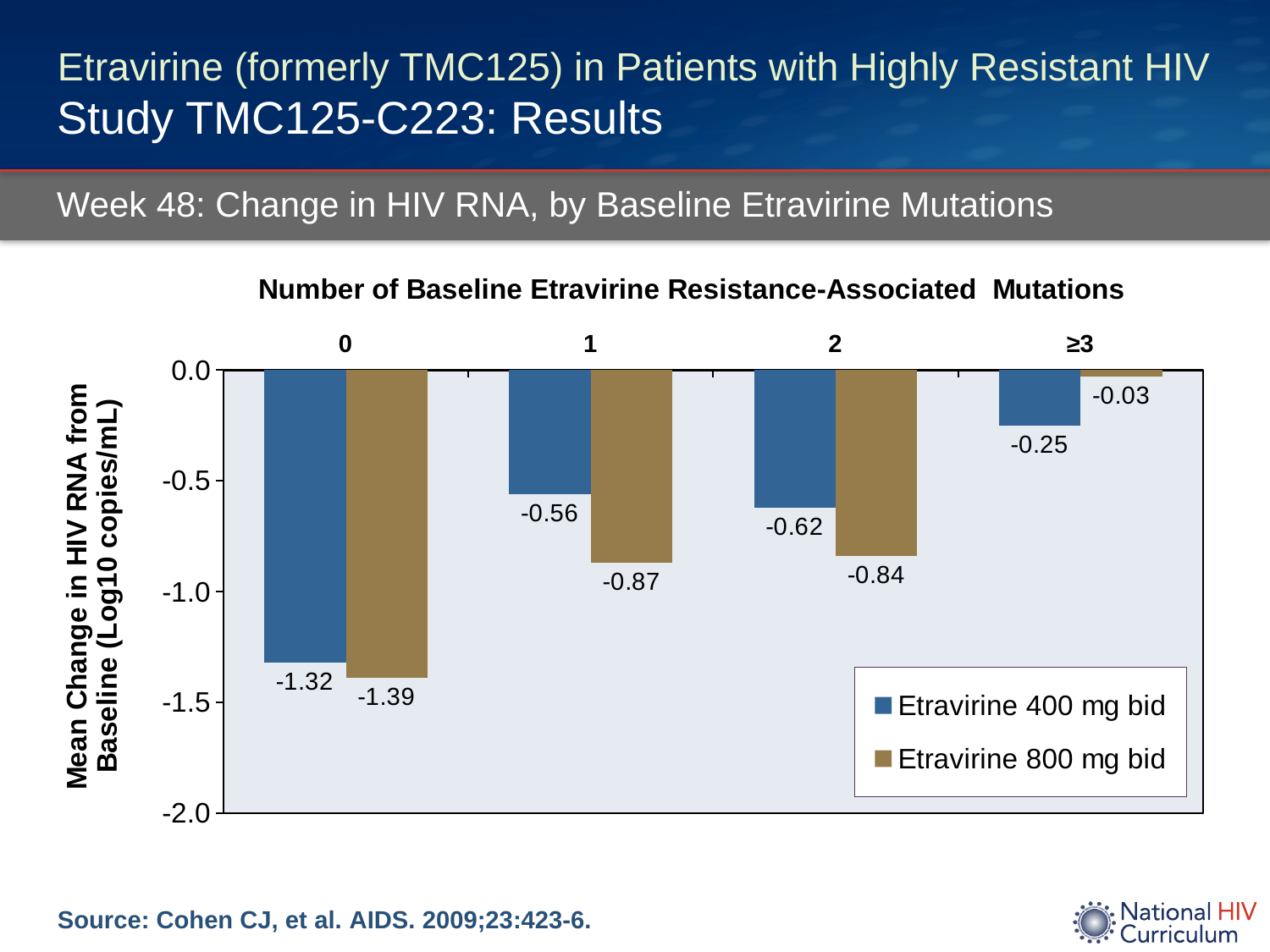
Which mutation category shows the smallest decrease in HIV RNA for Etravirine 400 mg bid? ≥3 How many series does the legend list? 2 What is the mean change in HIV RNA for Etravirine 400 mg bid in patients with 2 baseline mutations? -0.62 What is the difference between the Etravirine 800 mg bid and Etravirine 400 mg bid values for patients with 2 baseline mutations? 0.22 What is the mean change in HIV RNA for Etravirine 800 mg bid in patients with ≥3 baseline mutations? -0.03 As the number of baseline mutations increases from 0 to ≥3, does the magnitude of the decrease in HIV RNA for Etravirine 800 mg bid rise or fall? Fall What kind of chart is shown on the slide? Bar chart How many mutation categories are shown on the x axis? 4 For patients with 1 baseline mutation, which dose shows a larger decrease in HIV RNA: Etravirine 400 mg bid or Etravirine 800 mg bid? Etravirine 800 mg bid What is the mean change in HIV RNA for Etravirine 400 mg bid in patients with 0 baseline etravirine resistance-associated mutations? -1.32 What is the mean change in HIV RNA for Etravirine 800 mg bid in patients with 1 baseline etravirine resistance-associated mutation? -0.87 Which mutation category shows the largest decrease in HIV RNA for Etravirine 800 mg bid? 0